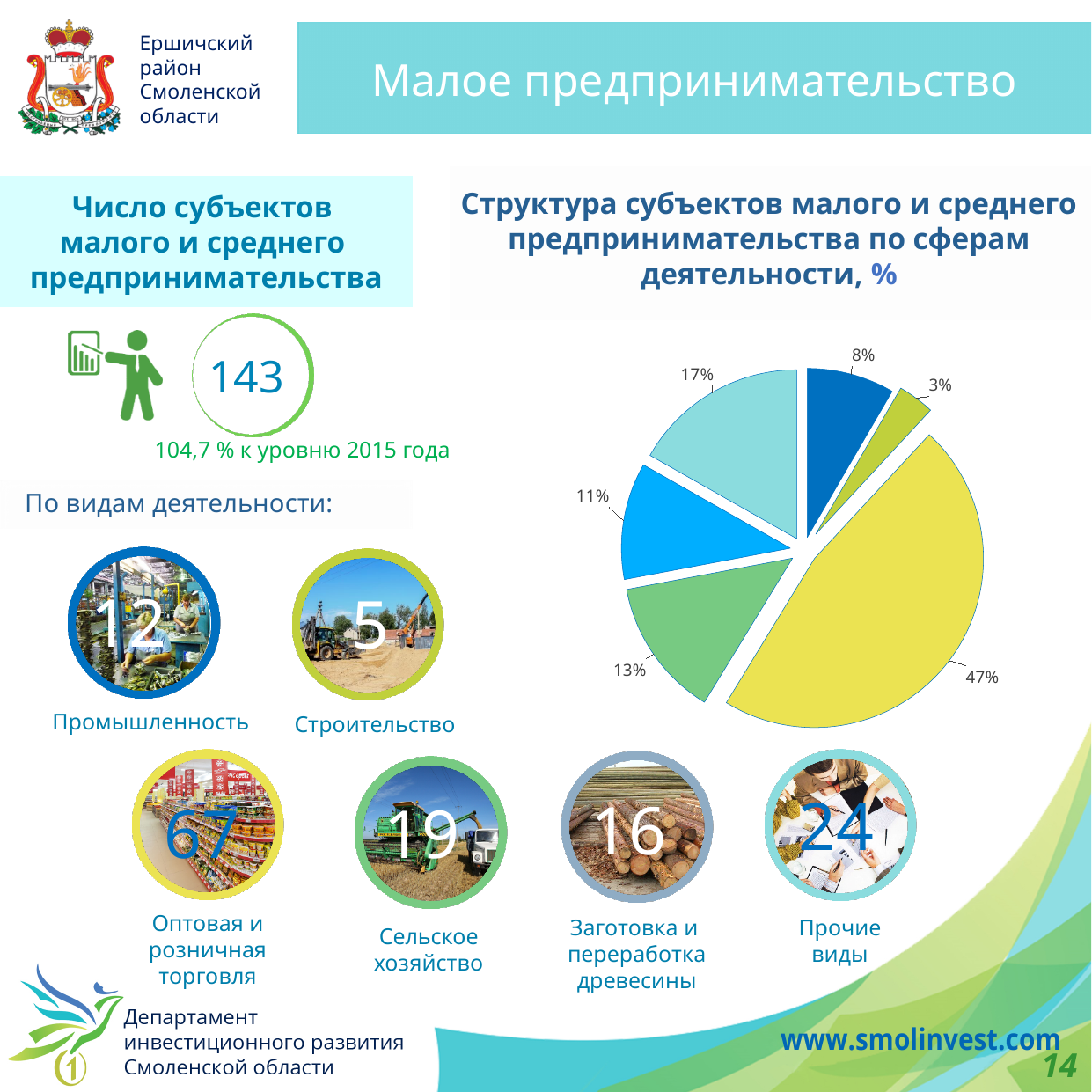
What value is labelled on the dark blue slice of the pie chart? 8% What value is labelled on the yellow slice of the pie chart? 47% What value is labelled on the light cyan slice of the pie chart? 17% What value is labelled on the green slice of the pie chart? 13% What is the difference between the 47% slice and the 17% slice of the pie chart? 30 percentage points What is the title of the pie chart? Структура субъектов малого и среднего предпринимательства по сферам деятельности, % How many slices does the pie chart have? 6 What is the value of the smallest slice of the pie chart? 3% Which is larger in the pie chart: the green slice or the bright blue slice? the green slice (13%) What is the value of the largest slice of the pie chart? 47% What kind of chart is shown on the right side of the slide? pie chart What colour is the slice labelled 11% in the pie chart? bright blue